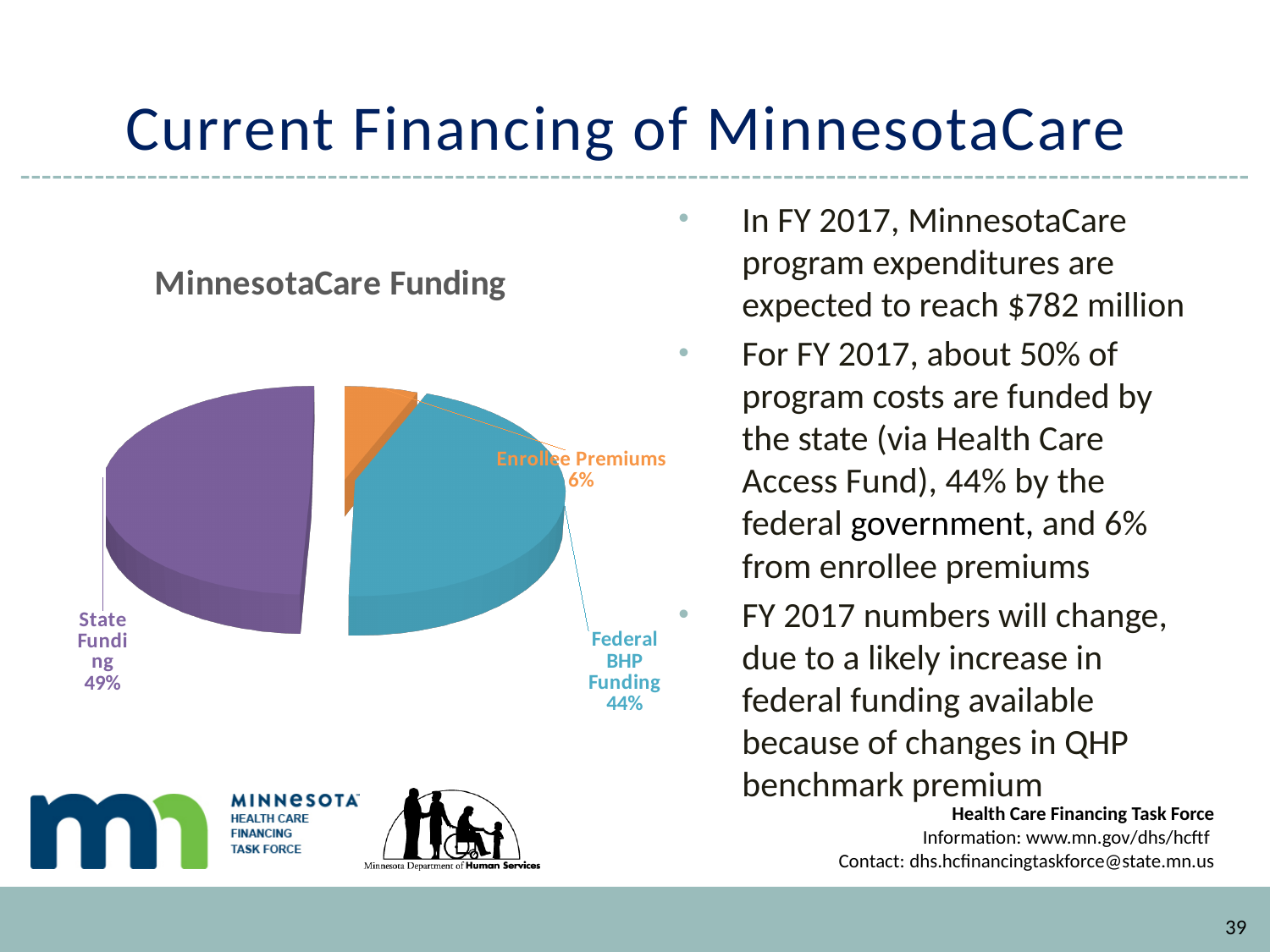
What colour is the Enrollee Premiums slice in the pie chart? Orange Which funding source has the largest share in the MinnesotaCare Funding pie chart? State Funding Which is larger, the share for Federal BHP Funding or the share for Enrollee Premiums? Federal BHP Funding Which funding source has the smallest share in the MinnesotaCare Funding pie chart? Enrollee Premiums What share of MinnesotaCare Funding comes from State Funding? 49% How many slices does the MinnesotaCare Funding pie chart have? 3 What kind of chart is shown on the slide? Pie chart What share of MinnesotaCare Funding comes from Enrollee Premiums? 6% What is the difference in percentage points between Federal BHP Funding and Enrollee Premiums? 38 percentage points What is the difference in percentage points between State Funding and Federal BHP Funding? 5 percentage points What is the title of the chart on the slide? MinnesotaCare Funding What share of MinnesotaCare Funding comes from Federal BHP Funding? 44%